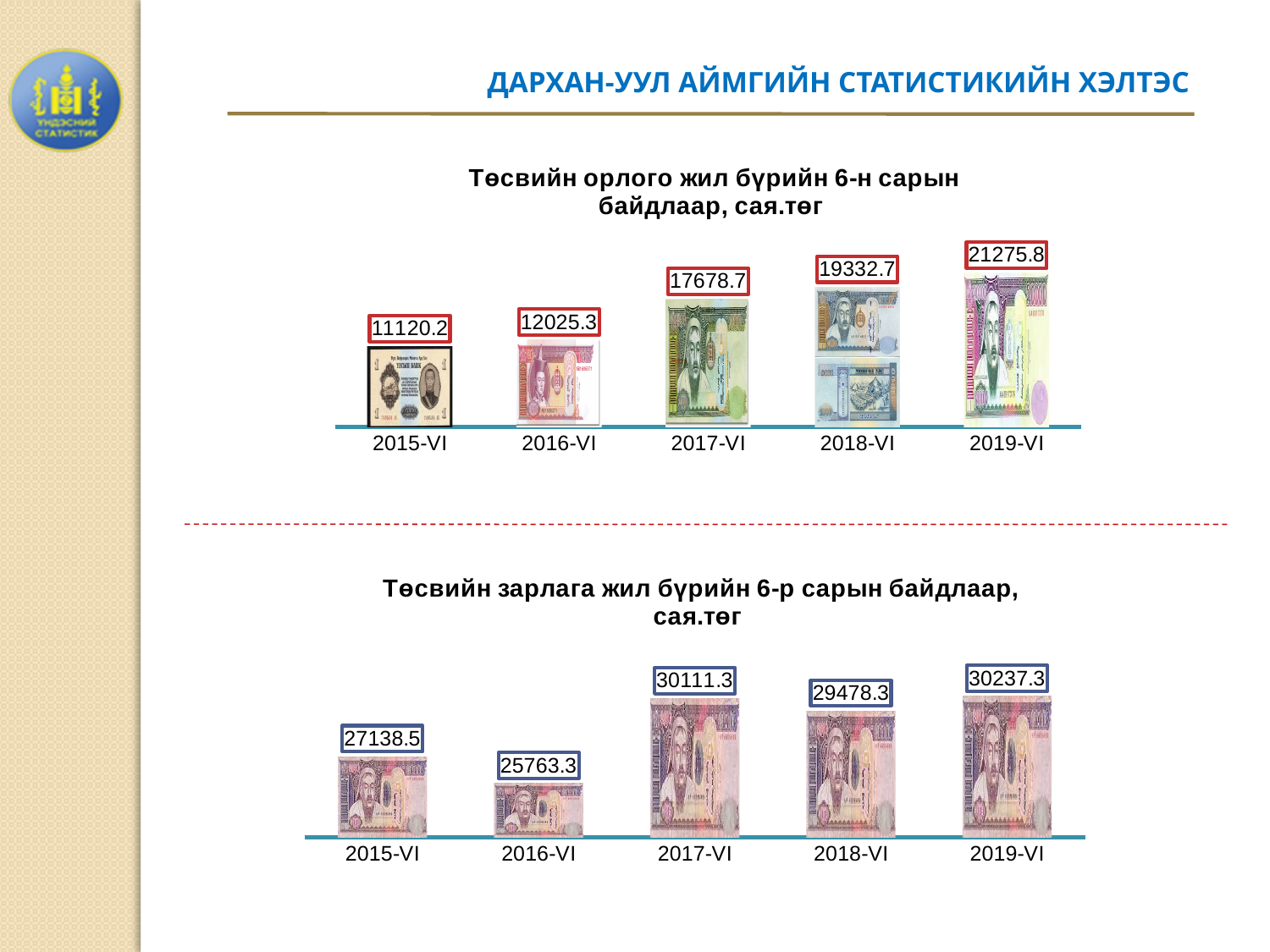
In the top chart (Төсвийн орлого), do the values rise or fall from 2015-VI to 2019-VI? rise In the bottom chart (Төсвийн зарлага), what is the difference between the 2017-VI and 2016-VI values? 4348.0 In the bottom chart (Төсвийн зарлага), what is the value for 2016-VI? 25763.3 In the top chart (Төсвийн орлого), what is the difference between the 2019-VI and 2015-VI values? 10155.6 In the bottom chart (Төсвийн зарлага), which year has the lowest value? 2016-VI How many categories are shown on the x axis of the bottom chart (Төсвийн зарлага)? 5 In the top chart (Төсвийн орлого), which year has the lowest value? 2015-VI In the top chart (Төсвийн орлого), what is the value for 2018-VI? 19332.7 In the top chart (Төсвийн орлого), what is the value for 2015-VI? 11120.2 In the bottom chart (Төсвийн зарлага), which is larger, the value for 2017-VI or 2018-VI? 2017-VI In the bottom chart (Төсвийн зарлага), what is the value for 2019-VI? 30237.3 In the top chart (Төсвийн орлого), which year has the highest value? 2019-VI